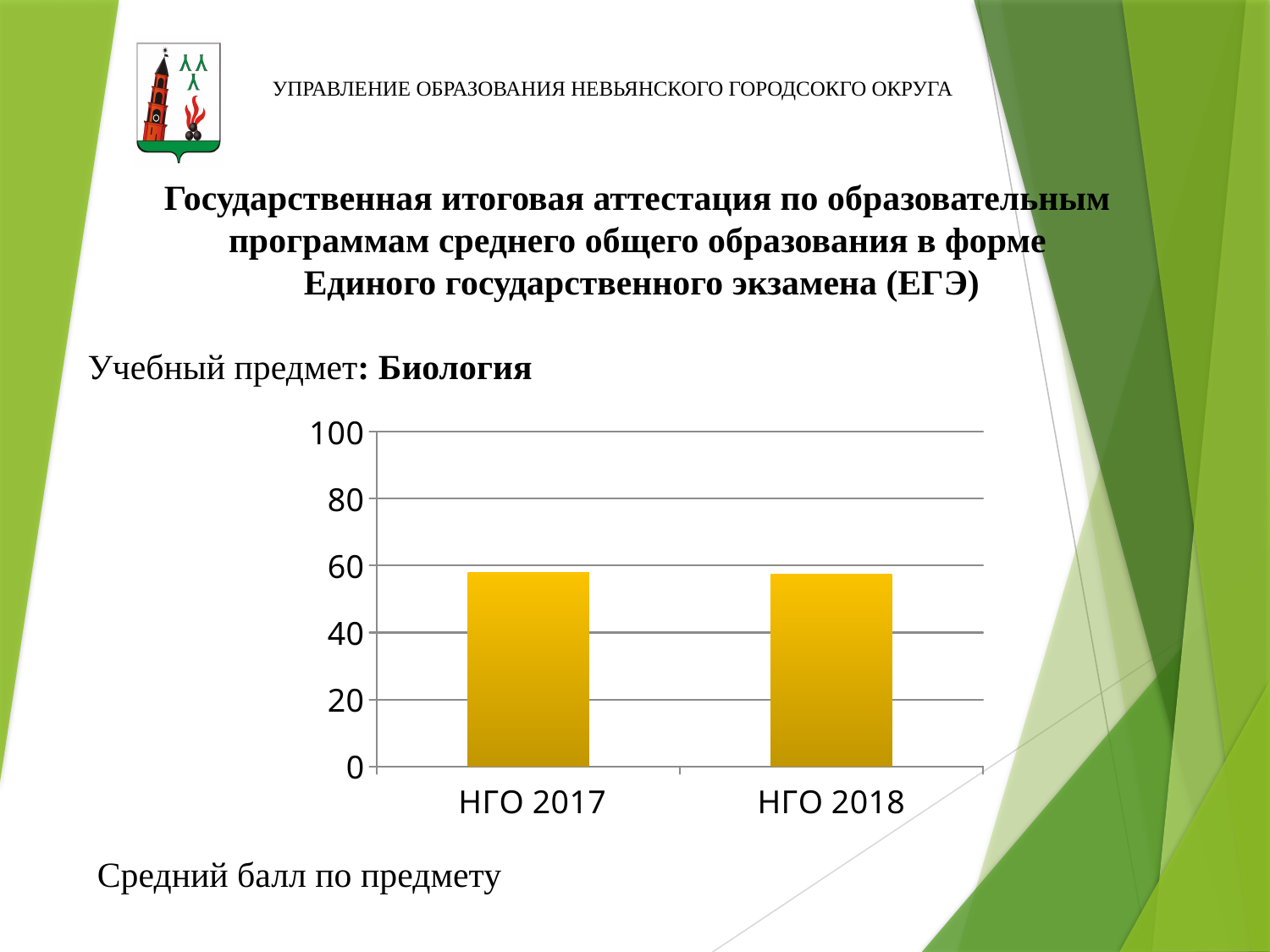
What kind of chart is shown on the slide? bar chart Is the value for НГО 2017 greater or less than 60? less Which school subject (учебный предмет) does the chart on the slide refer to? Биология What are the category labels on the x axis of the chart? НГО 2017, НГО 2018 Is the value for НГО 2018 greater or less than 80? less Is the value for НГО 2017 greater or less than 20? greater How many bars (categories) are plotted in the chart? 2